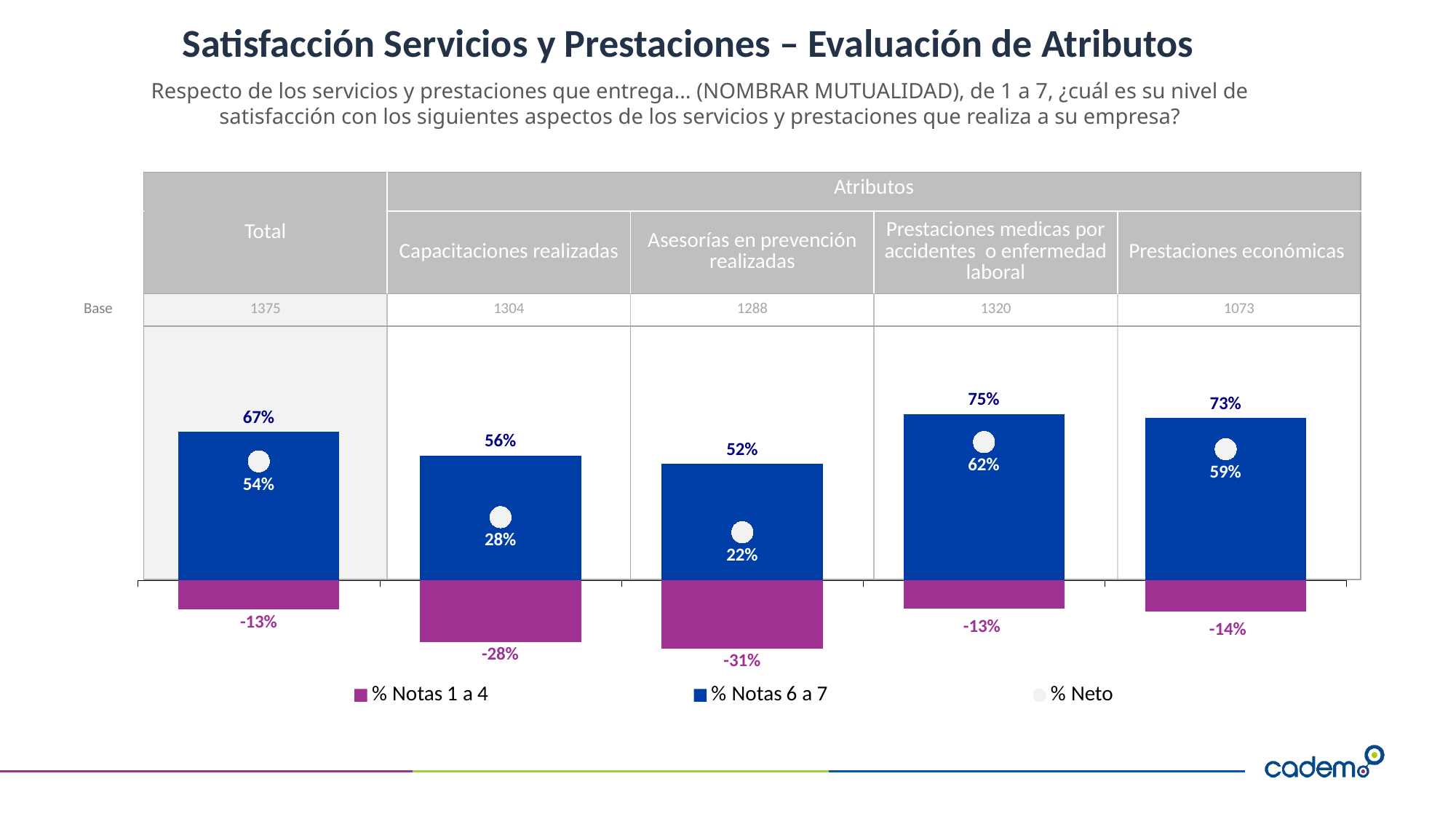
What is the base (number of respondents) shown for Prestaciones económicas? 1073 What is the % Neto value for Total? 54% Which category has the lowest % Neto value? Asesorías en prevención realizadas How many categories are shown on the x axis of the chart? 5 What kind of chart is shown on the slide? Bar chart What is the difference between the % Notas 6 a 7 values for Prestaciones medicas por accidentes o enfermedad laboral and Capacitaciones realizadas? 19% Which category has the highest % Notas 6 a 7 value? Prestaciones medicas por accidentes o enfermedad laboral What is the % Notas 1 a 4 value for Asesorías en prevención realizadas? -31% What is the % Notas 6 a 7 value for Capacitaciones realizadas? 56% What is the % Neto value for Prestaciones económicas? 59% Which is larger, the % Neto value for Prestaciones medicas por accidentes o enfermedad laboral or for Prestaciones económicas? Prestaciones medicas por accidentes o enfermedad laboral How many series does the legend list? 3